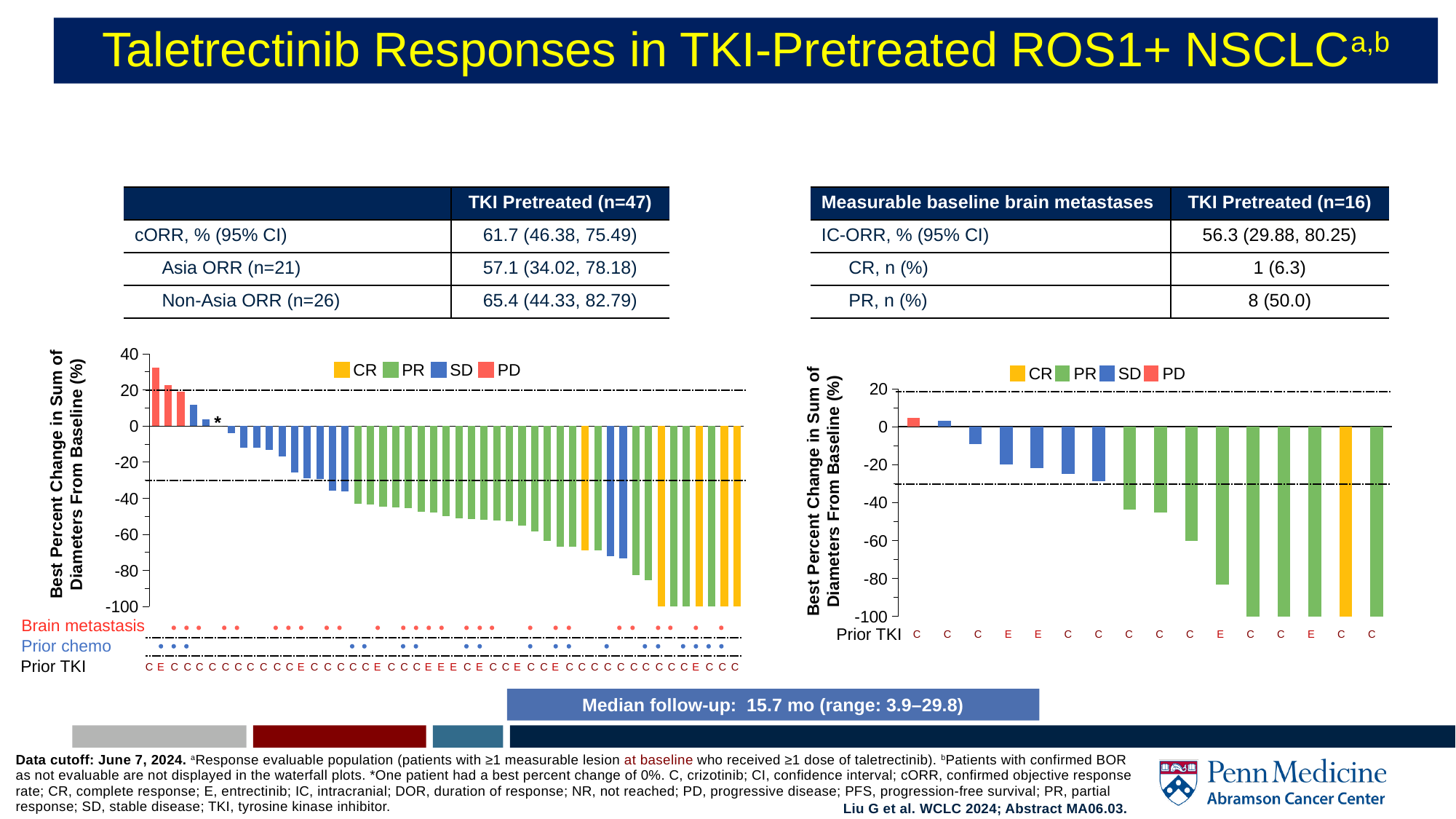
In the right-hand chart, is the value of the first (leftmost) bar greater or less than 20? less In the right-hand chart (measurable baseline brain metastases), how many patient bars are plotted? 16 In the left-hand chart, do the bar values rise or fall from left to right along the x axis? fall In the left-hand chart, is the value of the first (leftmost) bar greater or less than 20? greater In the right-hand chart, is the value of the CR bar greater or less than -80? less In the right-hand chart, how many bars are coloured as CR? 1 In the left-hand chart, how many bars are coloured as PD? 3 What colour represents SD in the legend of the waterfall charts? Blue How many response categories does the legend of the right-hand chart list? 4 In the left-hand chart, which response category does the bar with the highest value belong to? PD What kind of chart is shown on the left side of the slide? Bar chart